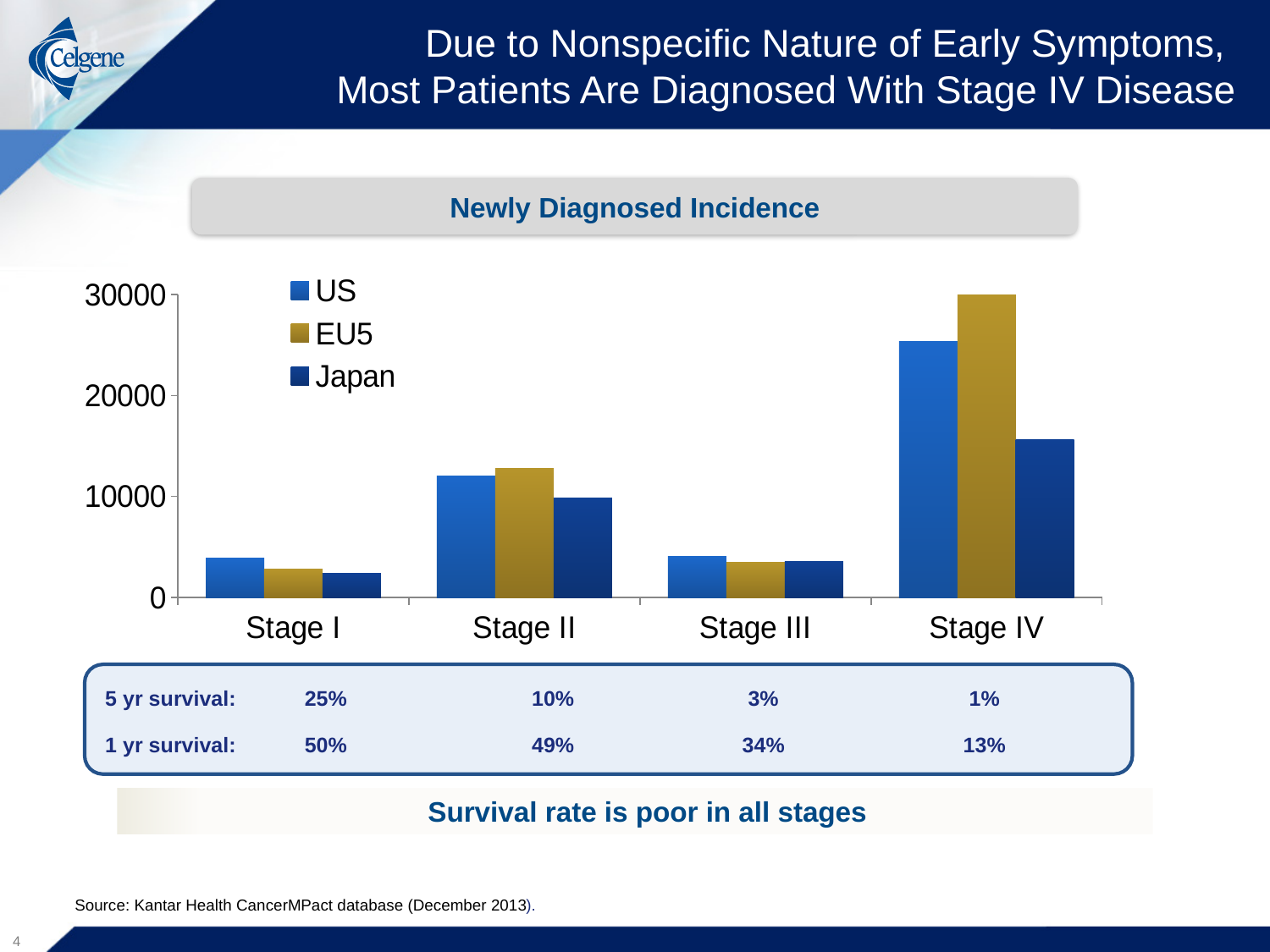
Is the Japan value for Stage IV in the Newly Diagnosed Incidence chart greater or less than 20000? less In the Newly Diagnosed Incidence chart, which stage has the highest US value? Stage IV Is the EU5 value for Stage I in the Newly Diagnosed Incidence chart greater or less than 10000? less How many stage categories are shown on the x axis of the Newly Diagnosed Incidence chart? 4 What kind of chart is shown under the title "Newly Diagnosed Incidence"? bar chart Is the US value for Stage IV in the Newly Diagnosed Incidence chart greater or less than 20000? greater What are the three legend entries of the Newly Diagnosed Incidence chart? US, EU5, Japan In the Newly Diagnosed Incidence chart, which stage has the lowest Japan value? Stage I In the Newly Diagnosed Incidence chart, for Stage IV, which is larger: the EU5 value or the Japan value? EU5 How many series does the legend of the Newly Diagnosed Incidence chart list? 3 In the Newly Diagnosed Incidence chart, is the US value larger for Stage II or for Stage IV? Stage IV